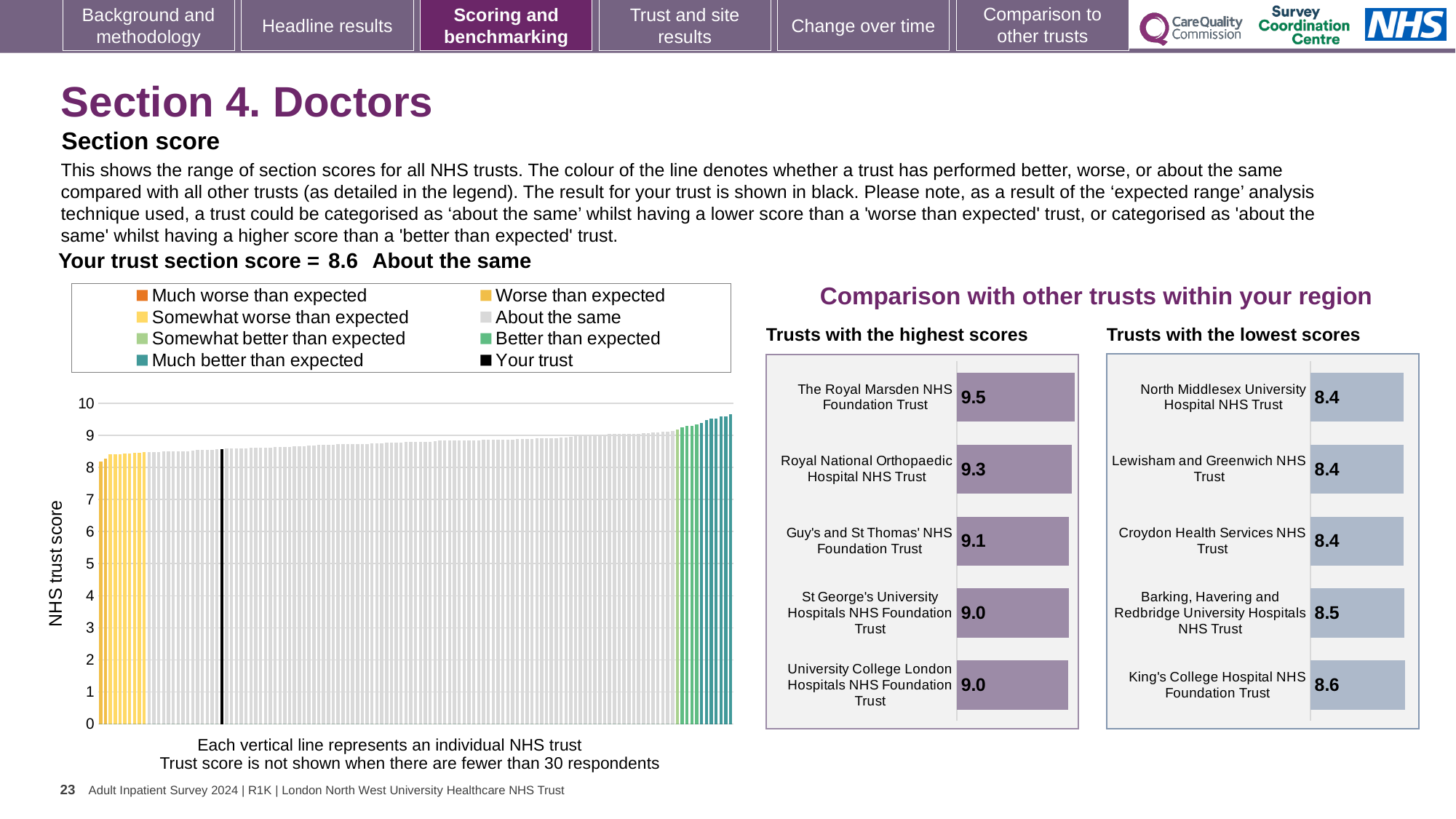
In the 'Trusts with the highest scores' chart, which trust has the highest score? The Royal Marsden NHS Foundation Trust In the large chart on the left, do the trust scores rise or fall from left to right along the x axis? rise In the large chart on the left, is the value for your trust (the black line) greater or less than 8? greater In the 'Trusts with the highest scores' chart, what is the difference between the scores of The Royal Marsden NHS Foundation Trust and Guy's and St Thomas' NHS Foundation Trust? 0.4 In the 'Trusts with the lowest scores' chart, which is larger: the score for King's College Hospital NHS Foundation Trust or the score for Croydon Health Services NHS Trust? King's College Hospital NHS Foundation Trust What kind of chart is the large chart on the left showing NHS trust scores? bar chart In the 'Trusts with the highest scores' chart, what is the score for The Royal Marsden NHS Foundation Trust? 9.5 In the 'Trusts with the lowest scores' chart, what is the score for King's College Hospital NHS Foundation Trust? 8.6 How many entries does the legend of the large chart on the left list? 8 How many trusts are shown in the 'Trusts with the highest scores' chart? 5 In the large chart on the left, what is the section score for your trust? 8.6 In the 'Trusts with the lowest scores' chart, what is the difference between the scores of King's College Hospital NHS Foundation Trust and North Middlesex University Hospital NHS Trust? 0.2